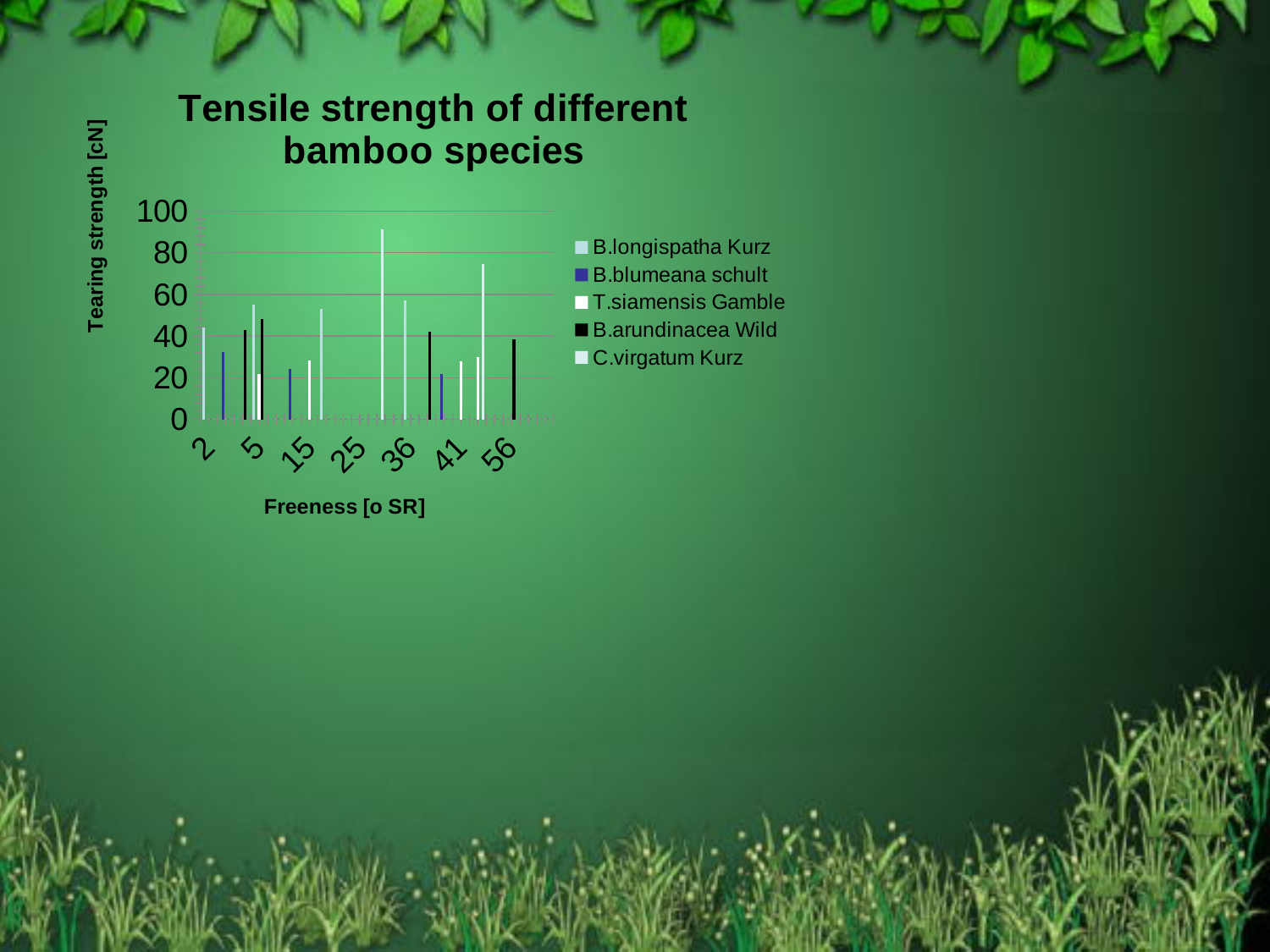
What kind of chart is shown on the slide? bar chart What is the label of the y axis? Tearing strength [cN] What is the title of the chart? Tensile strength of different bamboo species Is the tallest bar on the chart greater or less than 80? greater What is the highest value shown on the y axis? 100 Is the tallest bar on the chart greater or less than 100? less What is the first category on the x axis? 2 How many series does the legend list? 5